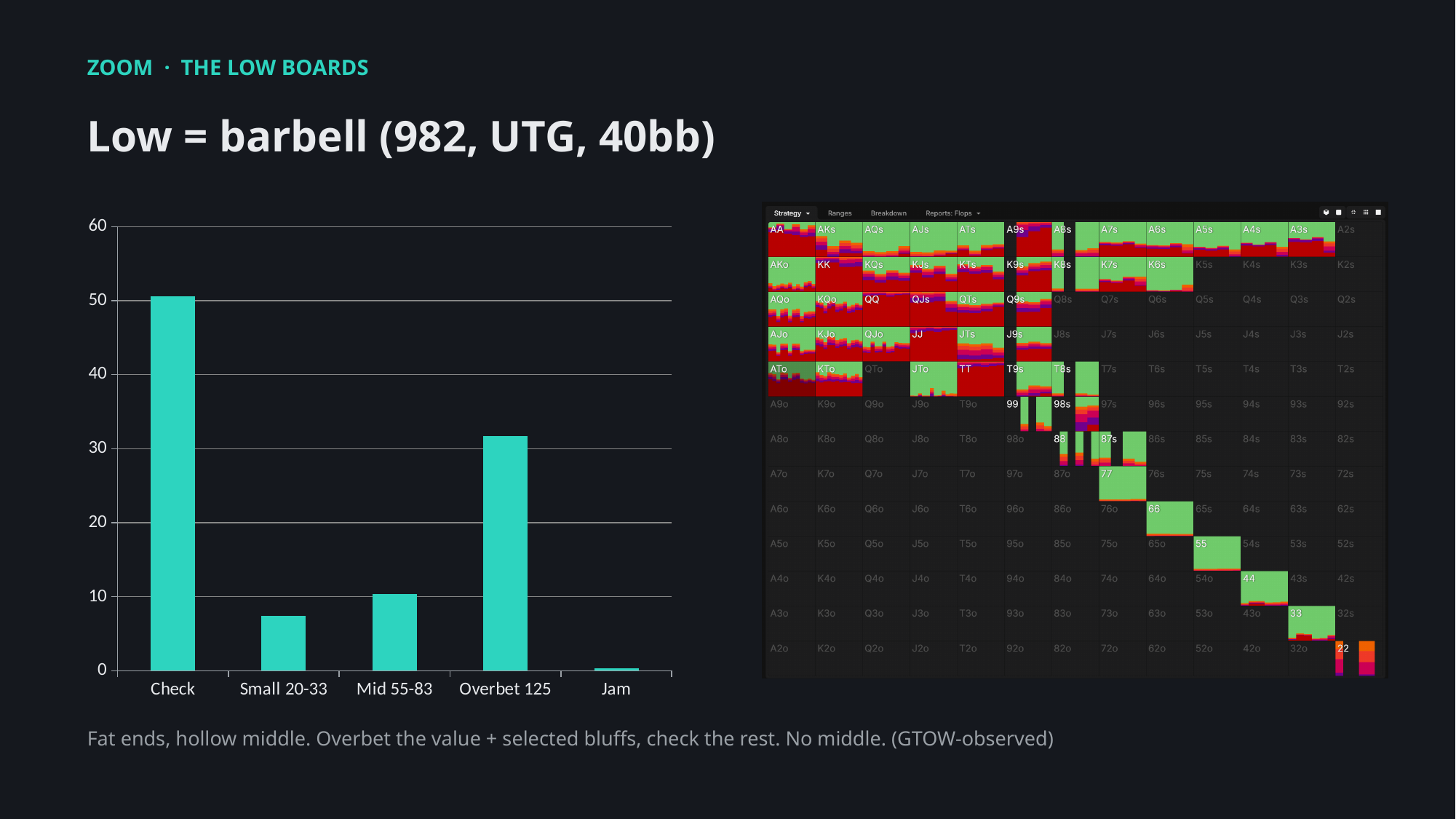
Which is larger, the value for Check or the value for Overbet 125? Check Is the value for Small 20-33 greater or less than 10? less Which is larger, the value for Small 20-33 or the value for Mid 55-83? Mid 55-83 Is the value for Overbet 125 greater or less than 30? greater What is the title of the slide containing the bar chart? Low = barbell (982, UTG, 40bb) How many categories are shown on the x axis of the bar chart? 5 Is the value for Jam greater or less than 10? less Which category has the lowest bar in the chart? Jam What kind of chart is shown on the left of the slide? bar chart Which category has the highest bar in the chart? Check